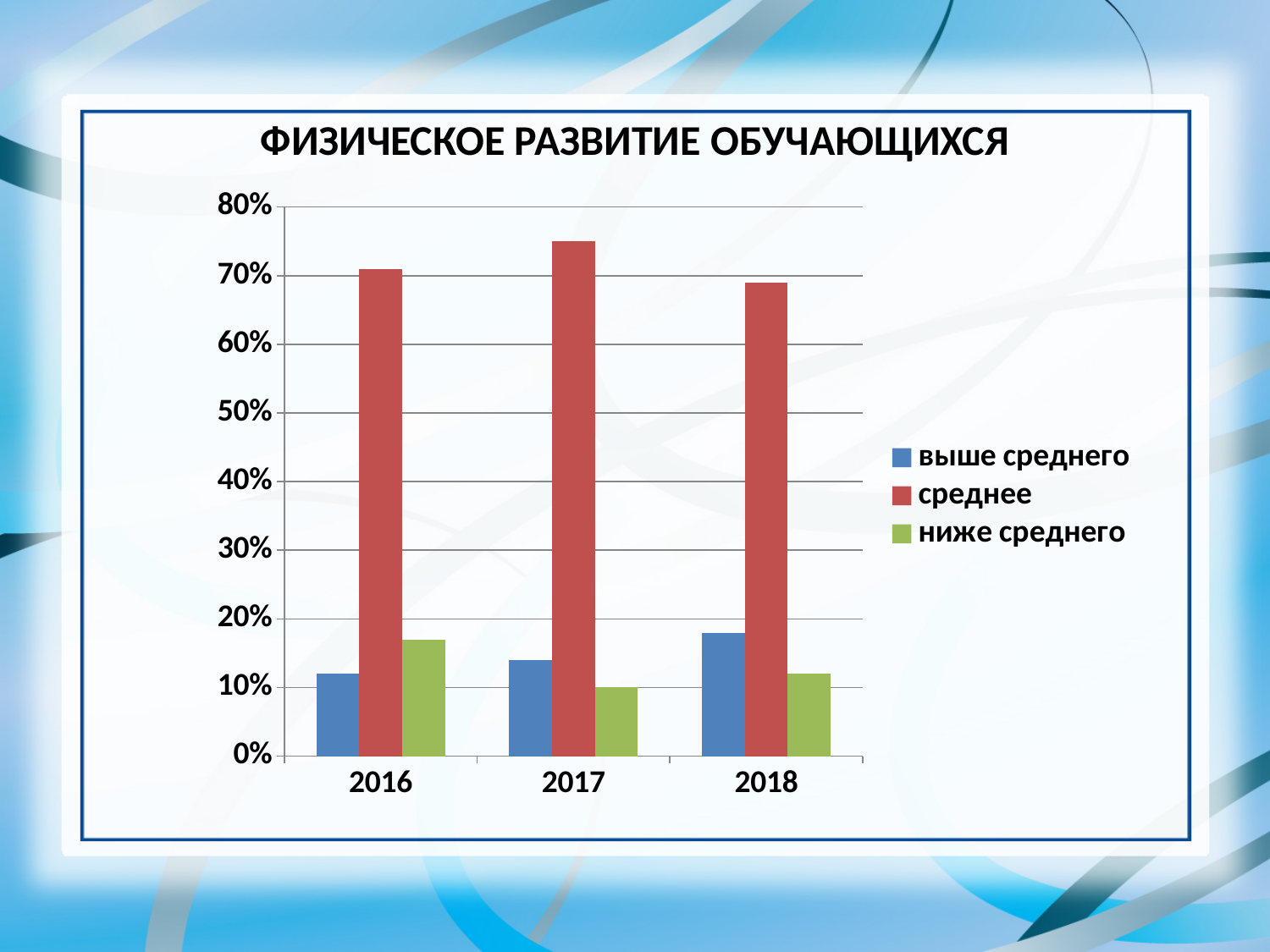
Does the value for "выше среднего" rise or fall from 2016 to 2018? rise How many years are shown on the x axis? 3 Is the value for "ниже среднего" in 2016 greater or less than 20%? less How many series does the legend list? 3 Is the value for "выше среднего" in 2018 greater or less than 20%? less Which year has the highest value for "выше среднего"? 2018 What kind of chart is shown on the slide? bar chart Which year has the lowest value for "ниже среднего"? 2017 Is the value for "среднее" in 2017 greater or less than 70%? greater What is the title of the chart? ФИЗИЧЕСКОЕ РАЗВИТИЕ ОБУЧАЮЩИХСЯ Which year has the highest value for "среднее"? 2017 In 2016, which is larger: "выше среднего" or "ниже среднего"? ниже среднего